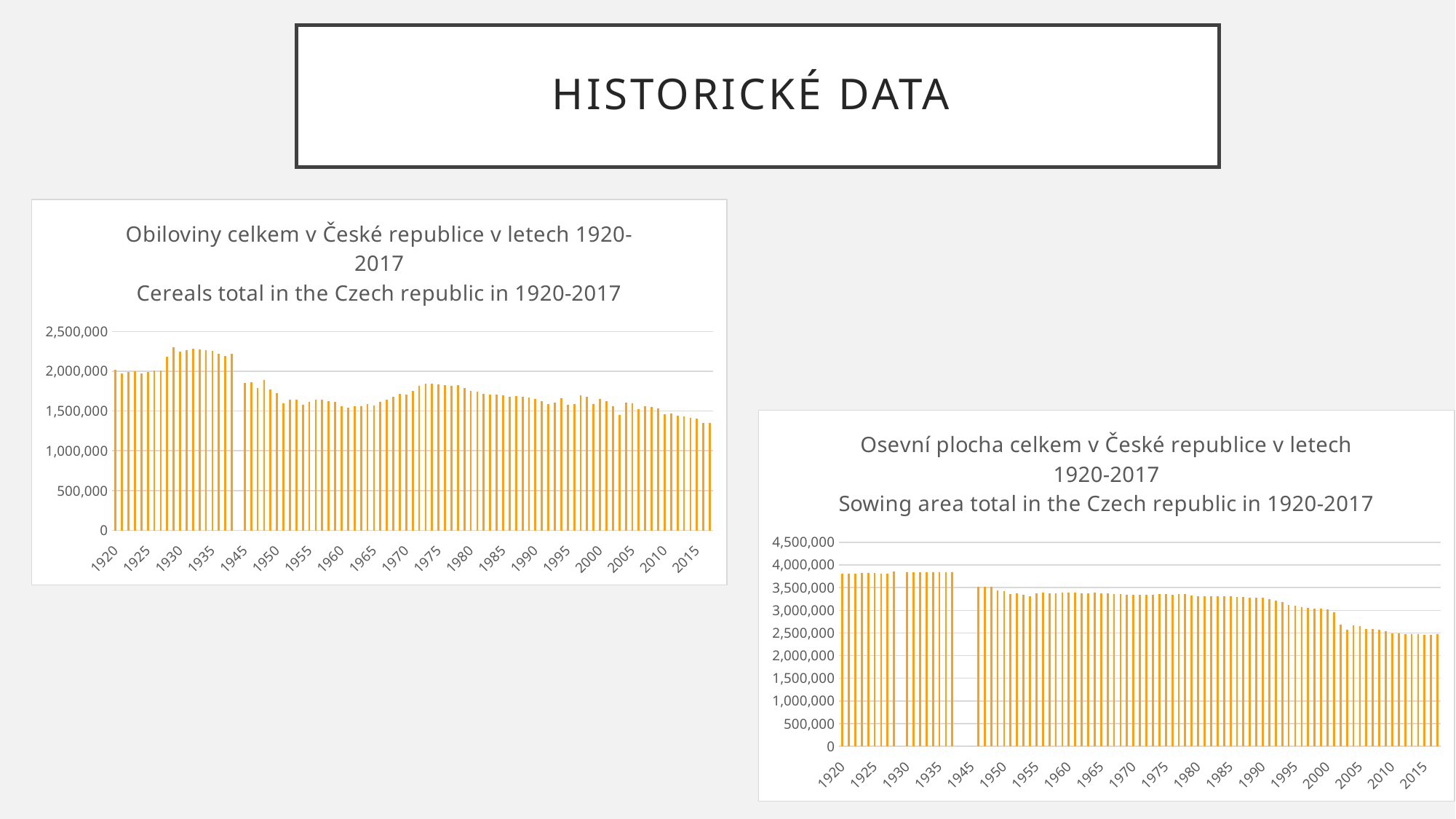
In the 'Sowing area total in the Czech republic in 1920-2017' chart, which is larger, the value for 1920 or the value for 2010? 1920 In the 'Sowing area total in the Czech republic in 1920-2017' chart, is the value for 1990 greater or less than 3,000,000? greater In the 'Sowing area total in the Czech republic in 1920-2017' chart, do the values overall rise or fall from 1920 to 2017? fall In the 'Cereals total in the Czech republic in 1920-2017' chart, is the value for 1930 greater or less than 2,000,000? greater In the 'Sowing area total in the Czech republic in 1920-2017' chart, is the value for 2005 greater or less than 3,000,000? less How many charts are shown on the slide? 2 What kind of chart is the 'Sowing area total in the Czech republic in 1920-2017' chart? bar chart What kind of chart is the 'Cereals total in the Czech republic in 1920-2017' chart? bar chart In the 'Cereals total in the Czech republic in 1920-2017' chart, which is larger, the value for 1930 or the value for 1960? 1930